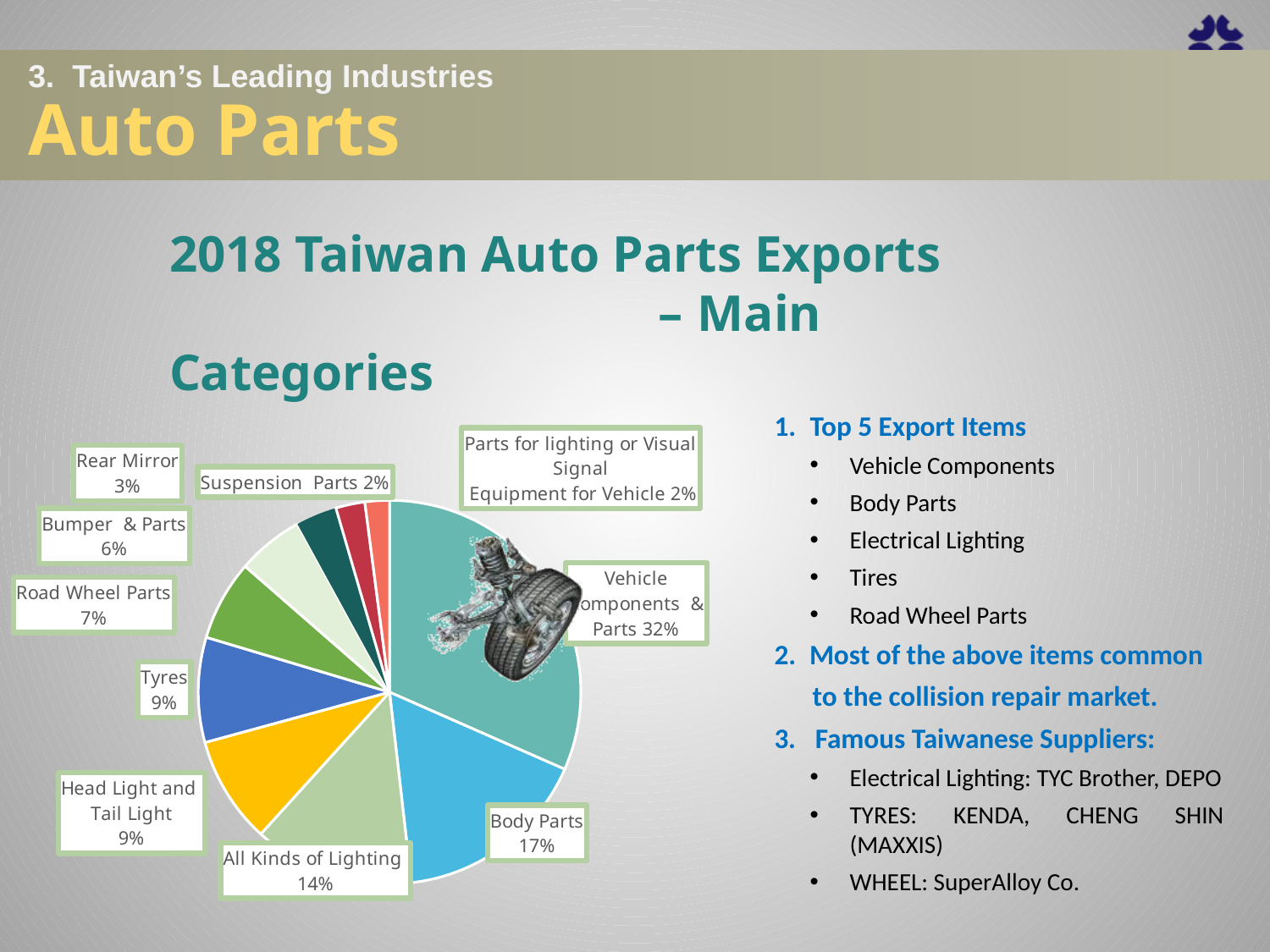
What kind of chart is shown on the slide? pie chart What is the difference in percentage points between All Kinds of Lighting and Rear Mirror? 11 What percentage does the Body Parts slice represent? 17% Which is larger, the share for Tyres or the share for Bumper & Parts? Tyres What is the difference in percentage points between Vehicle Components & Parts and Body Parts? 15 What percentage is shown for Suspension Parts? 2% What percentage is shown for Road Wheel Parts? 7% Which category has the largest share of the pie? Vehicle Components & Parts What is the share for All Kinds of Lighting? 14% How many categories are shown in the pie chart? 10 What is the title of the chart? 2018 Taiwan Auto Parts Exports – Main Categories What share of 2018 Taiwan auto parts exports is Vehicle Components & Parts? 32%